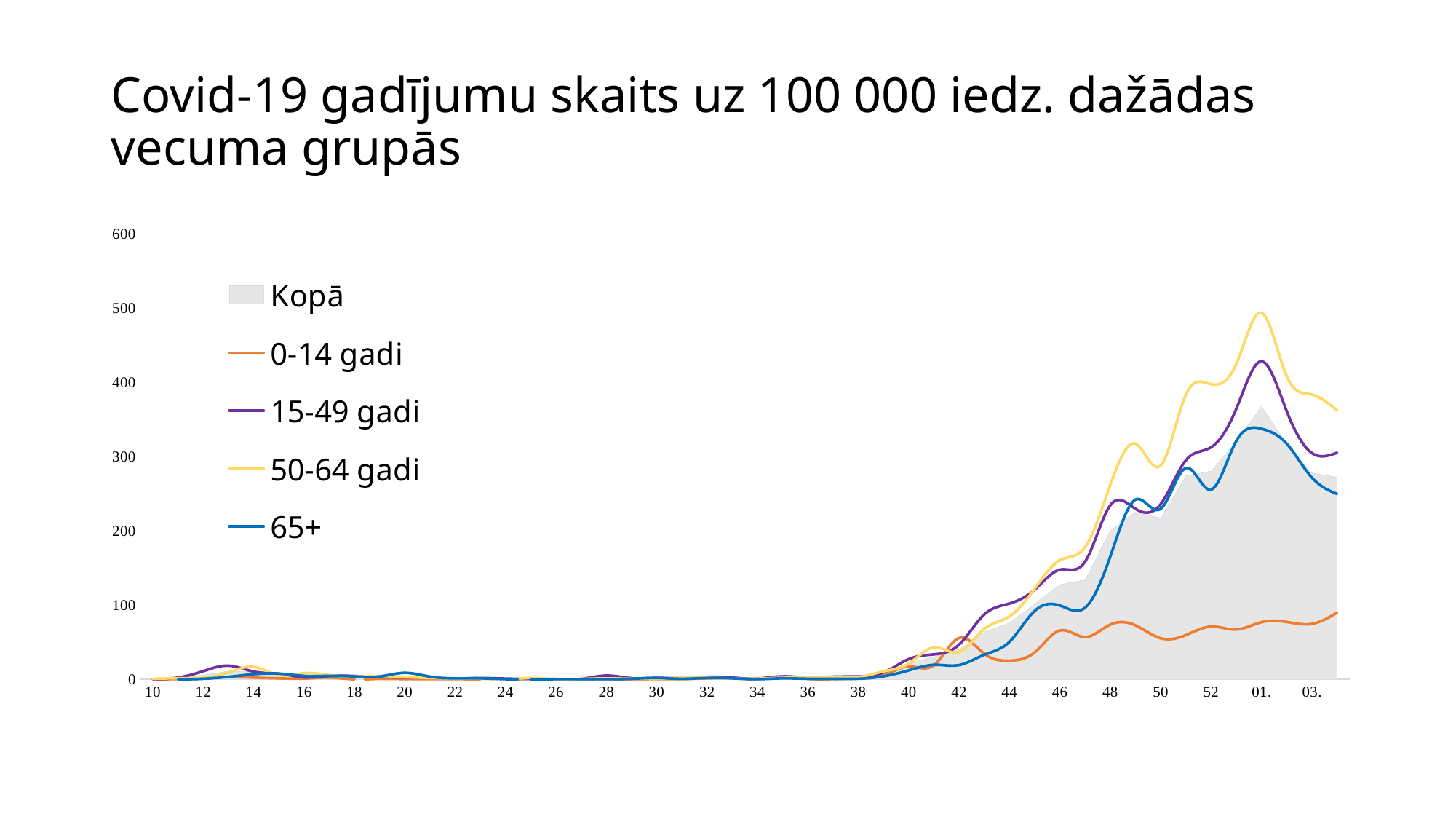
What is the title of the chart? Covid-19 gadījumu skaits uz 100 000 iedz. dažādas vecuma grupās Is the value for 0-14 gadi at week 01. greater or less than 100? less Is the value for 15-49 gadi at week 38 greater or less than 100? less Which legend entry is shown as a shaded grey area rather than a line? Kopā Which series has the highest value at week 01.? 50-64 gadi Does the value for 50-64 gadi rise or fall between week 38 and week 01.? rise Is the value for 65+ at week 01. greater or less than 300? greater At week 01., which is larger: the value for 50-64 gadi or the value for 65+? 50-64 gadi How many series does the legend list? 5 Which series has the lowest value at week 01.? 0-14 gadi What kind of chart is shown on the slide? combination area and line chart